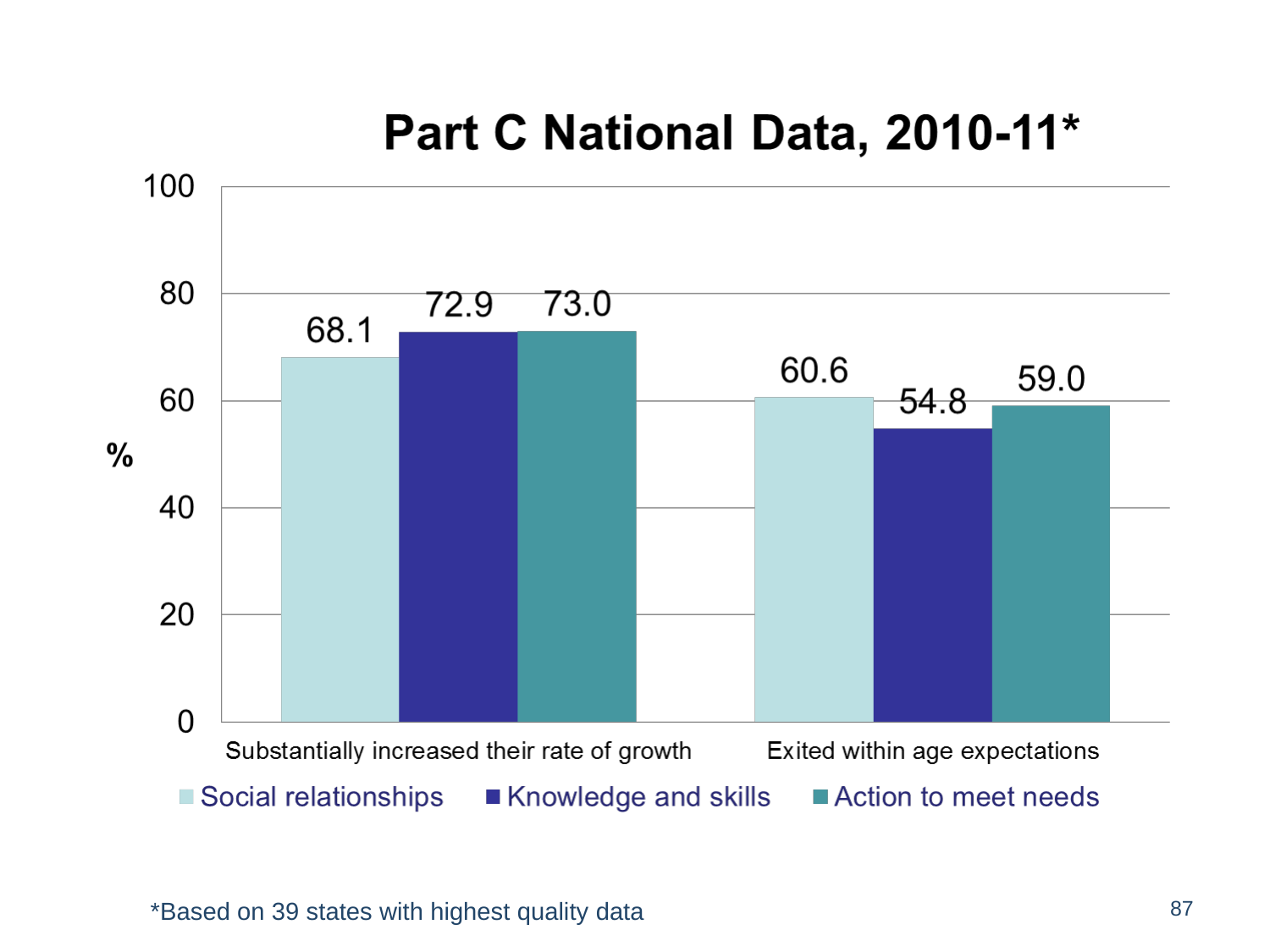
What is the value for Knowledge and skills in the 'Exited within age expectations' category? 54.8 How many categories are shown on the x axis? 2 Which series has the lowest value in the 'Exited within age expectations' category? Knowledge and skills How many series does the legend list? 3 Which series has the lowest value in the 'Substantially increased their rate of growth' category? Social relationships What is the value for Social relationships in the 'Substantially increased their rate of growth' category? 68.1 What is the value for Action to meet needs in the 'Substantially increased their rate of growth' category? 73.0 What is the difference between Action to meet needs and Knowledge and skills in the 'Exited within age expectations' category? 4.2 Is the value for Knowledge and skills in the 'Exited within age expectations' category greater or less than 60? less What kind of chart is shown on the slide? Bar chart Which is larger: Social relationships or Action to meet needs in the 'Exited within age expectations' category? Social relationships What is the difference between the Social relationships values for the two categories? 7.5